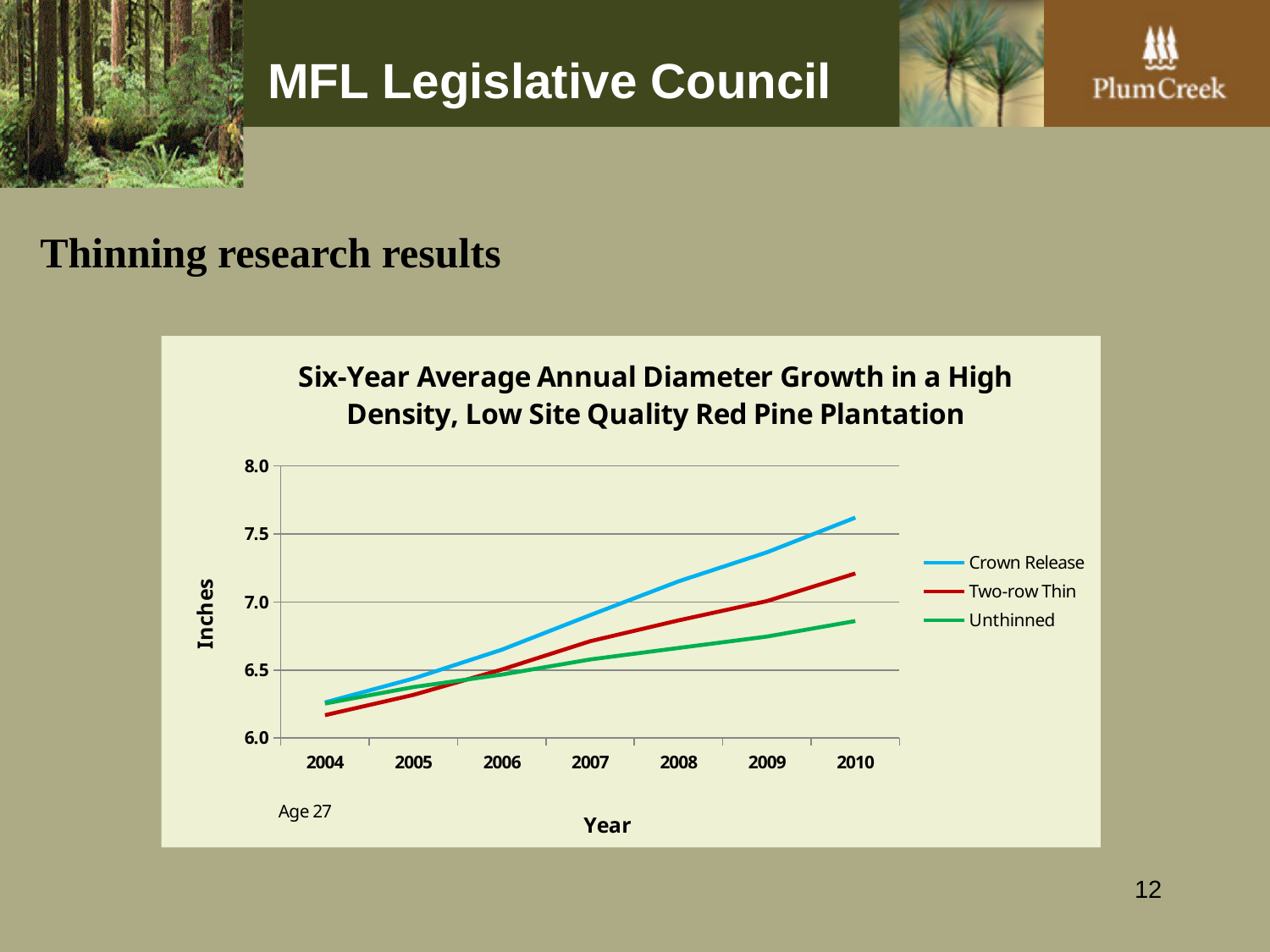
Which series has the lowest value in 2010? Unthinned Is the value for Two-row Thin in 2010 greater or less than 7.0? greater Which series has the highest value in 2010? Crown Release How many series does the legend list? 3 Is the value for Unthinned in 2010 greater or less than 7.0? less In 2010, which is larger: Crown Release or Unthinned? Crown Release What is the label on the y axis? Inches Do the values for Crown Release rise or fall from 2004 to 2010? Rise Is the value for Crown Release in 2010 greater or less than 7.0? greater How many years are plotted along the x axis? 7 What kind of chart is shown on the slide? Line chart